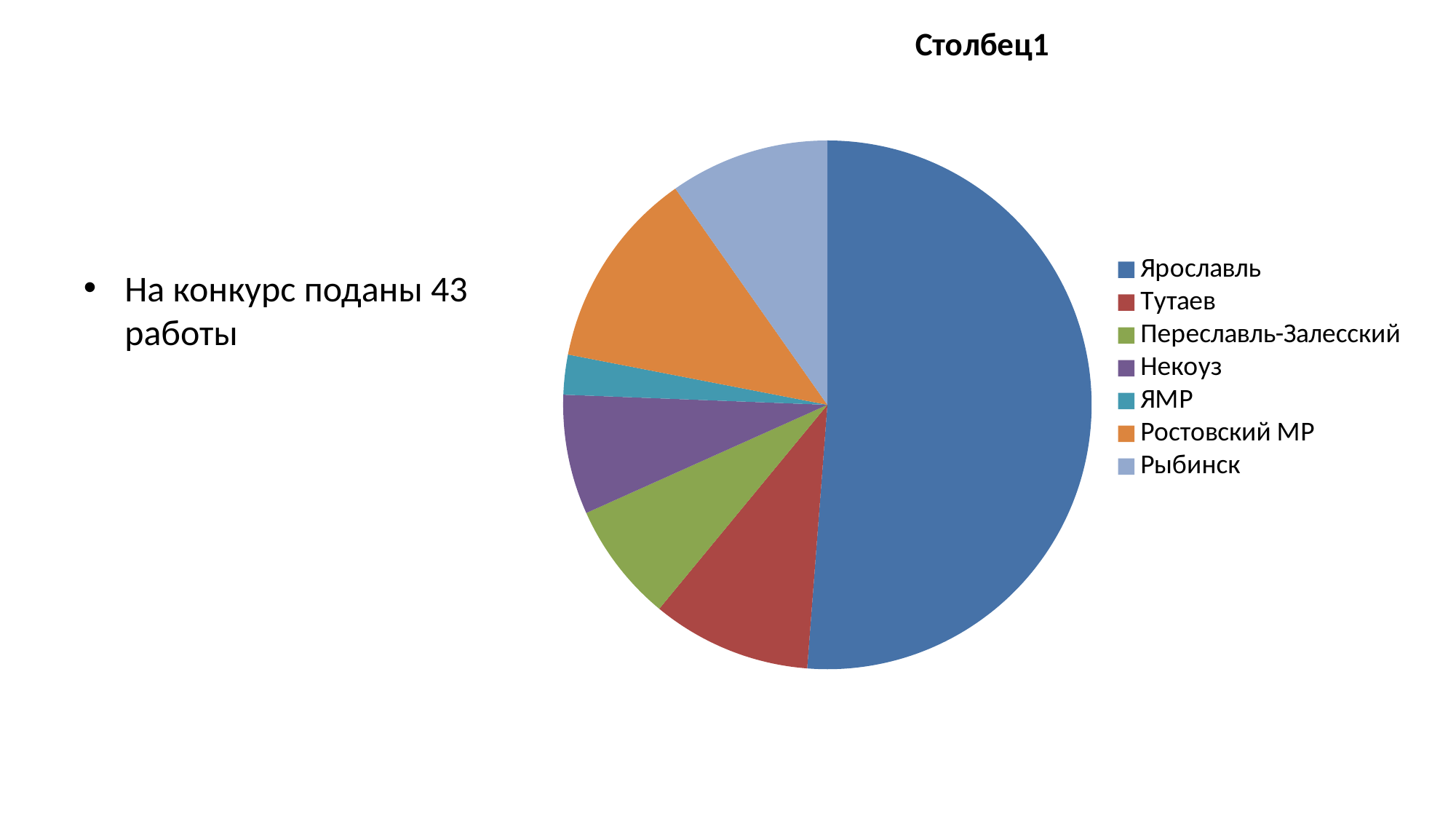
Which category has the smallest slice of the pie chart? ЯМР What kind of chart is shown on the slide? pie chart Which slice is larger, Тутаев or Переславль-Залесский? Тутаев What is the title of the pie chart? Столбец1 Which slice is larger, Ростовский МР or Рыбинск? Ростовский МР How many categories does the pie chart show? 7 Which slice is larger, Ростовский МР or Тутаев? Ростовский МР Which category has the largest slice of the pie chart? Ярославль Which category is shown in orange in the pie chart? Ростовский МР